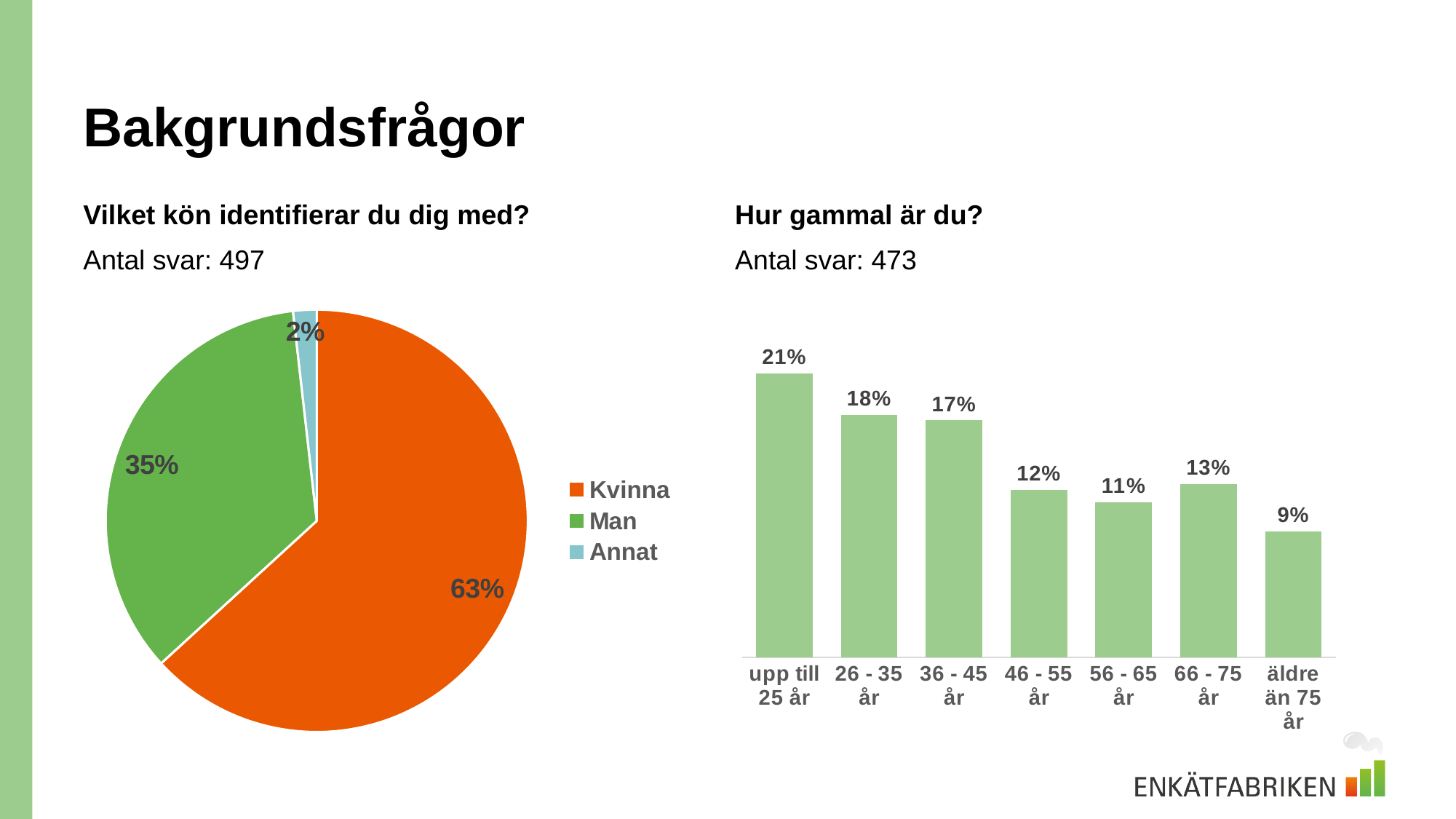
In the bar chart 'Hur gammal är du?', which age group has the highest value? upp till 25 år In the bar chart 'Hur gammal är du?', which is larger: the value for '56 - 65 år' or '66 - 75 år'? 66 - 75 år In the bar chart 'Hur gammal är du?', what is the value for '36 - 45 år'? 17% In the pie chart 'Vilket kön identifierar du dig med?', how many categories does the legend list? 3 In the bar chart 'Hur gammal är du?', what is the difference in percentage points between 'upp till 25 år' and '46 - 55 år'? 9 What kind of chart is used for 'Hur gammal är du?'? bar chart In the pie chart 'Vilket kön identifierar du dig med?', what share is labelled for Kvinna? 63% In the pie chart 'Vilket kön identifierar du dig med?', what share is labelled for Man? 35% In the pie chart 'Vilket kön identifierar du dig med?', which category has the smallest slice? Annat In the bar chart 'Hur gammal är du?', which age group has the lowest value? äldre än 75 år In the pie chart 'Vilket kön identifierar du dig med?', what is the difference in percentage points between Kvinna and Man? 28 In the bar chart 'Hur gammal är du?', how many age groups are shown? 7